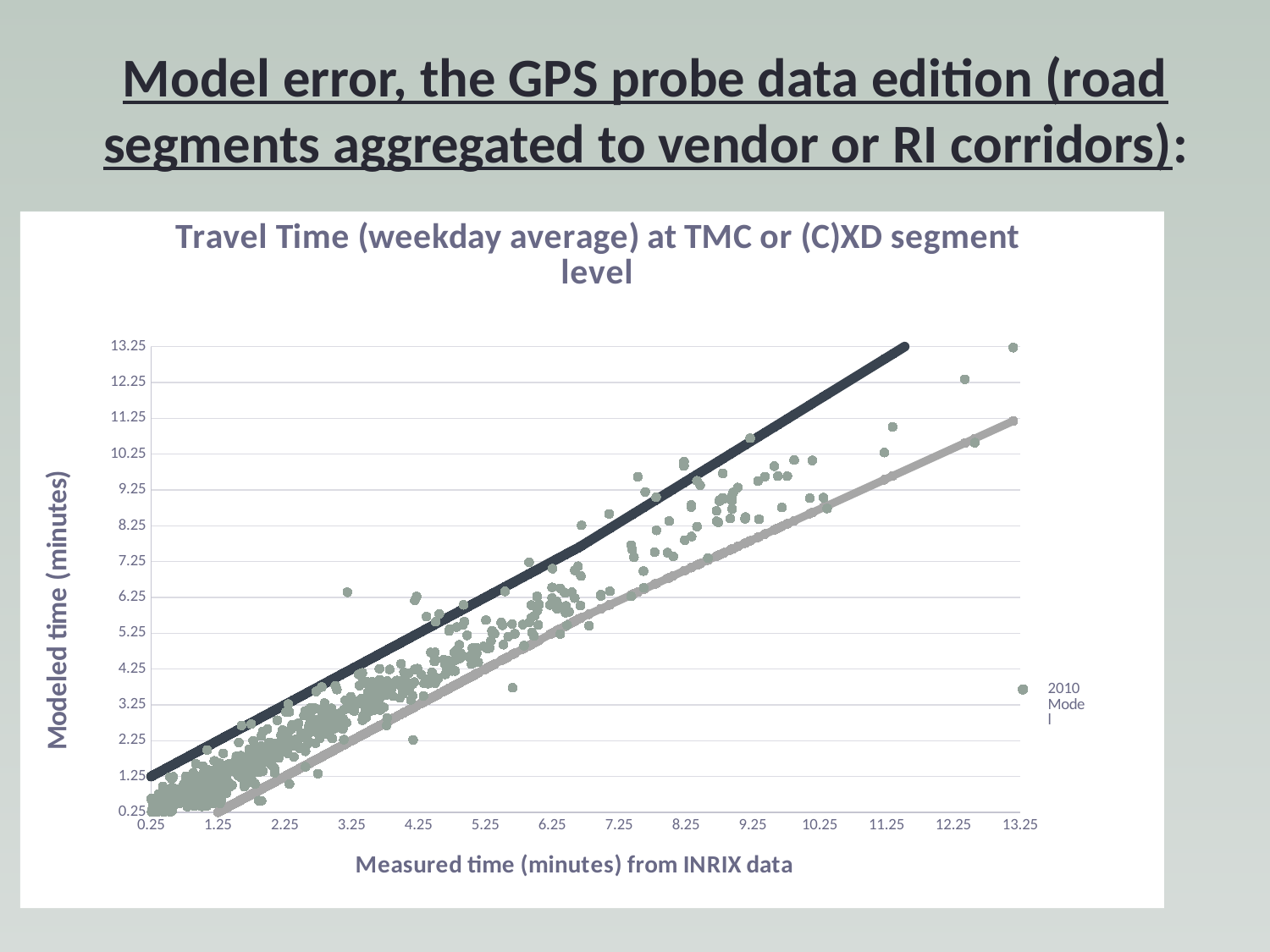
What kind of chart is shown on the slide? scatter chart How many series does the legend list? 1 What is the title of the chart? Travel Time (weekday average) at TMC or (C)XD segment level What is the name of the series listed in the legend? 2010 Model Is the modeled time of the point with the largest measured time greater or less than 12.25? greater Do the modeled time values generally rise or fall as measured time increases along the x axis? rise Is the lowest modeled time value plotted greater or less than 1.25? less